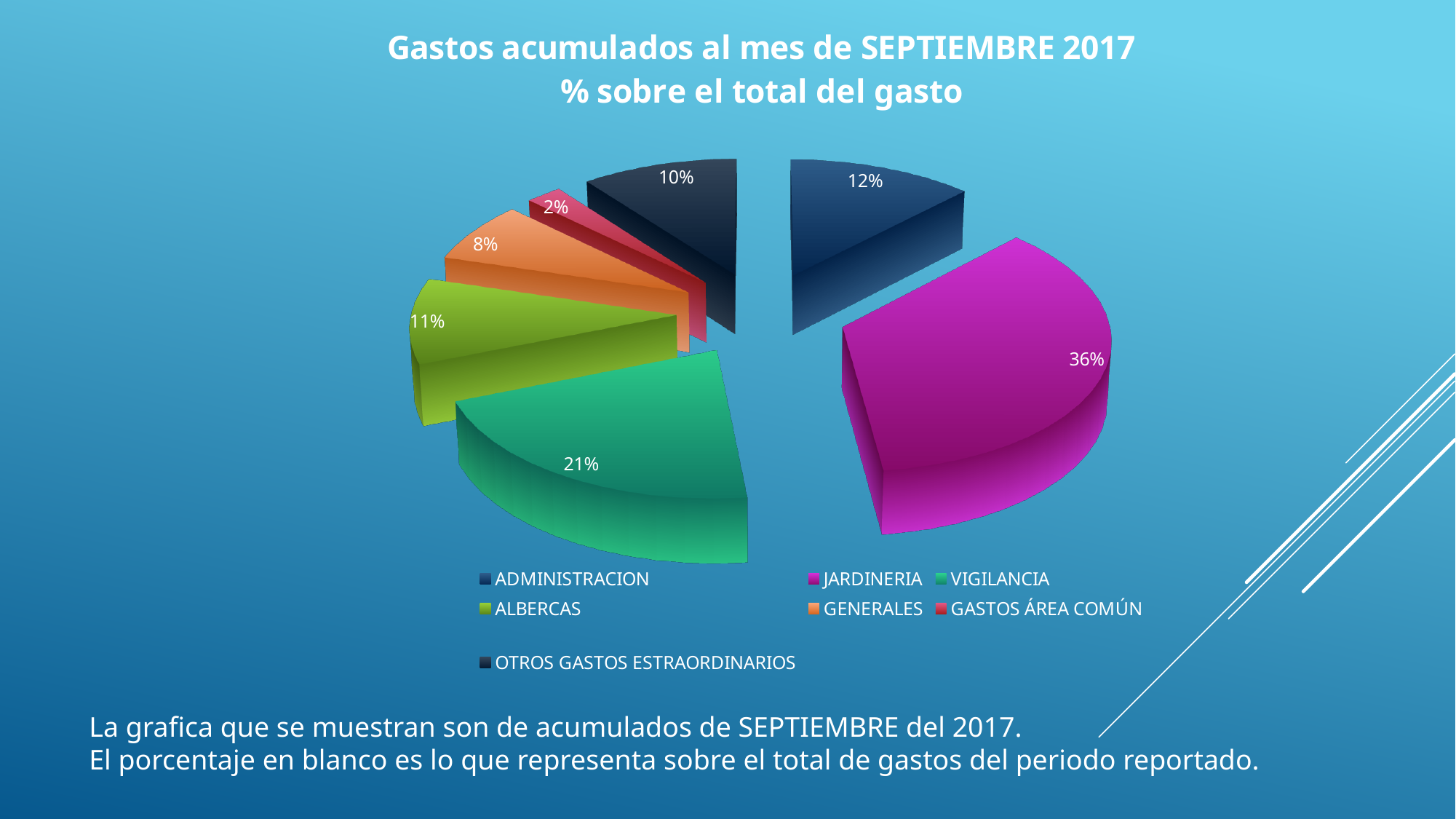
What is the difference in percentage points between JARDINERIA and VIGILANCIA? 15 What percentage of the total expense does OTROS GASTOS ESTRAORDINARIOS represent? 10% What percentage of the total expense does GASTOS ÁREA COMÚN represent? 2% What percentage of the total expense does ADMINISTRACION represent? 12% What kind of chart is shown on the slide? Pie chart Which category has the smallest share of the total expense? GASTOS ÁREA COMÚN What percentage of the total expense does VIGILANCIA represent? 21% Which has a larger share, ALBERCAS or GENERALES? ALBERCAS What percentage of the total expense does JARDINERIA represent? 36% What is the title of the chart? Gastos acumulados al mes de SEPTIEMBRE 2017 % sobre el total del gasto How many categories does the pie chart show? 7 Which category has the largest share of the total expense? JARDINERIA